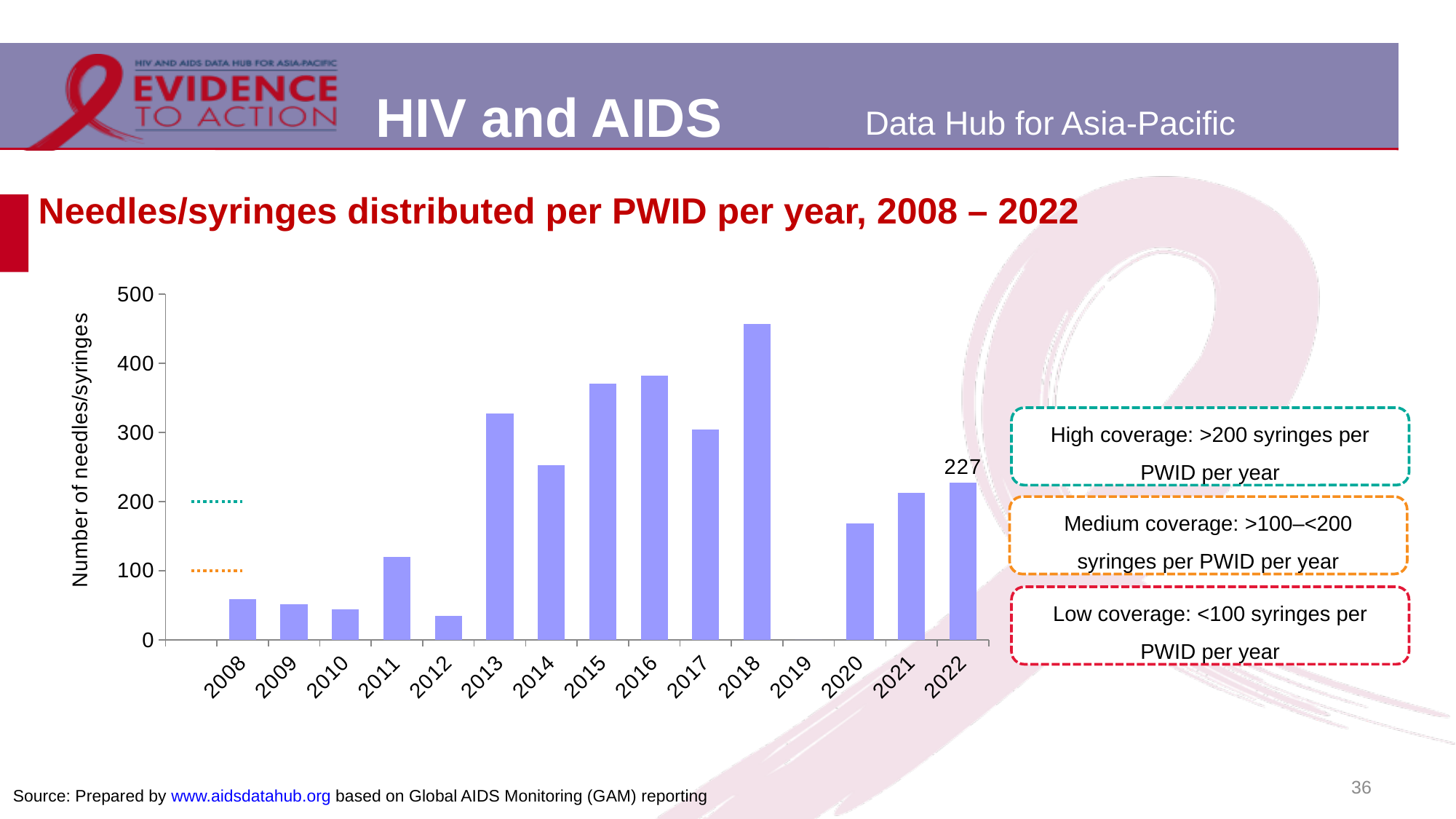
Which year on the x axis has no bar plotted? 2019 Is the value for 2011 greater or less than 100? greater Is the value for 2020 greater or less than 200? less What is the value shown for 2022? 227 What kind of chart is shown on the slide? Bar chart Which year has a larger value, 2020 or 2021? 2021 Which year has the highest number of needles/syringes distributed per PWID? 2018 Do the values rise or fall from 2020 to 2022? Rise Which year has the lowest bar in the chart? 2012 How many years are labeled on the x axis? 15 Is the value for 2018 greater or less than 400? greater Which year has a larger value, 2013 or 2014? 2013